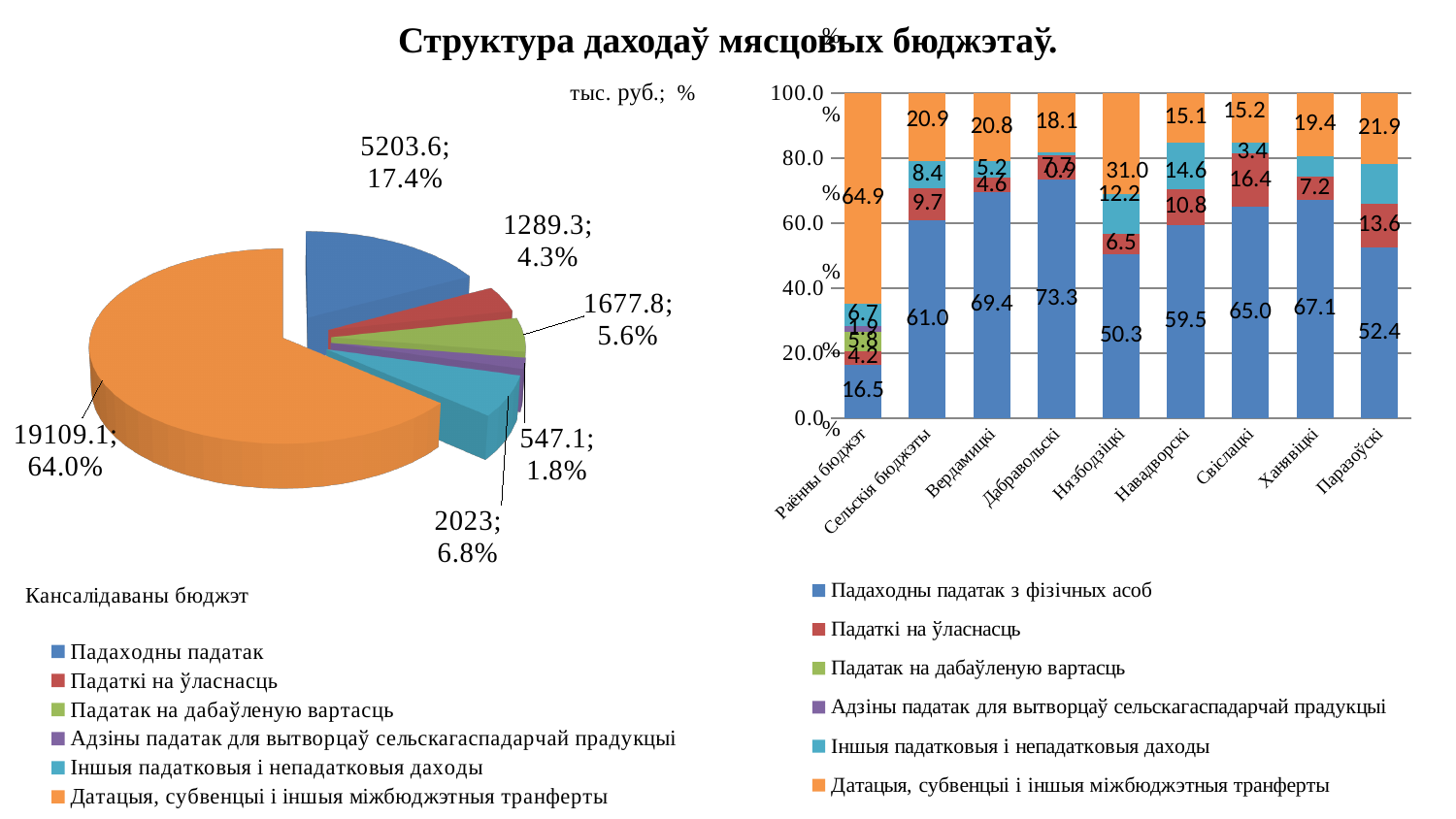
How many budget categories are shown on the x axis of the right bar chart? 9 In the left pie chart, what share does Датацыі, субвенцыі і іншыя міжбюджэтныя трансферты have? 64.0% What kind of chart is the right chart? stacked bar chart In the right bar chart, which category has the highest value for Падаходны падатак з фізічных асоб? Дабравольскі How many series does the legend of the right bar chart list? 6 In the left pie chart, which category has the smallest slice? Адзіны падатак для вытворцаў сельскагаспадарчай прадукцыі In the right bar chart, what is the value of Датацыі, субвенцыі і іншыя міжбюджэтныя трансферты for Нязбодзіцкі? 31.0 In the right bar chart, what is the value of Падаходны падатак з фізічных асоб for Дабравольскі? 73.3 In the right bar chart, which is larger for Датацыі, субвенцыі і іншыя міжбюджэтныя трансферты: Паразоўскі or Ханявіцкі? Паразоўскі In the left pie chart, what value is shown for Падаходны падатак? 5203.6 What kind of chart is the left chart (Кансалідаваны бюджэт)? pie chart In the right bar chart, what is the difference between the Датацыі, субвенцыі і іншыя міжбюджэтныя трансферты values for Паразоўскі and Ханявіцкі? 2.5